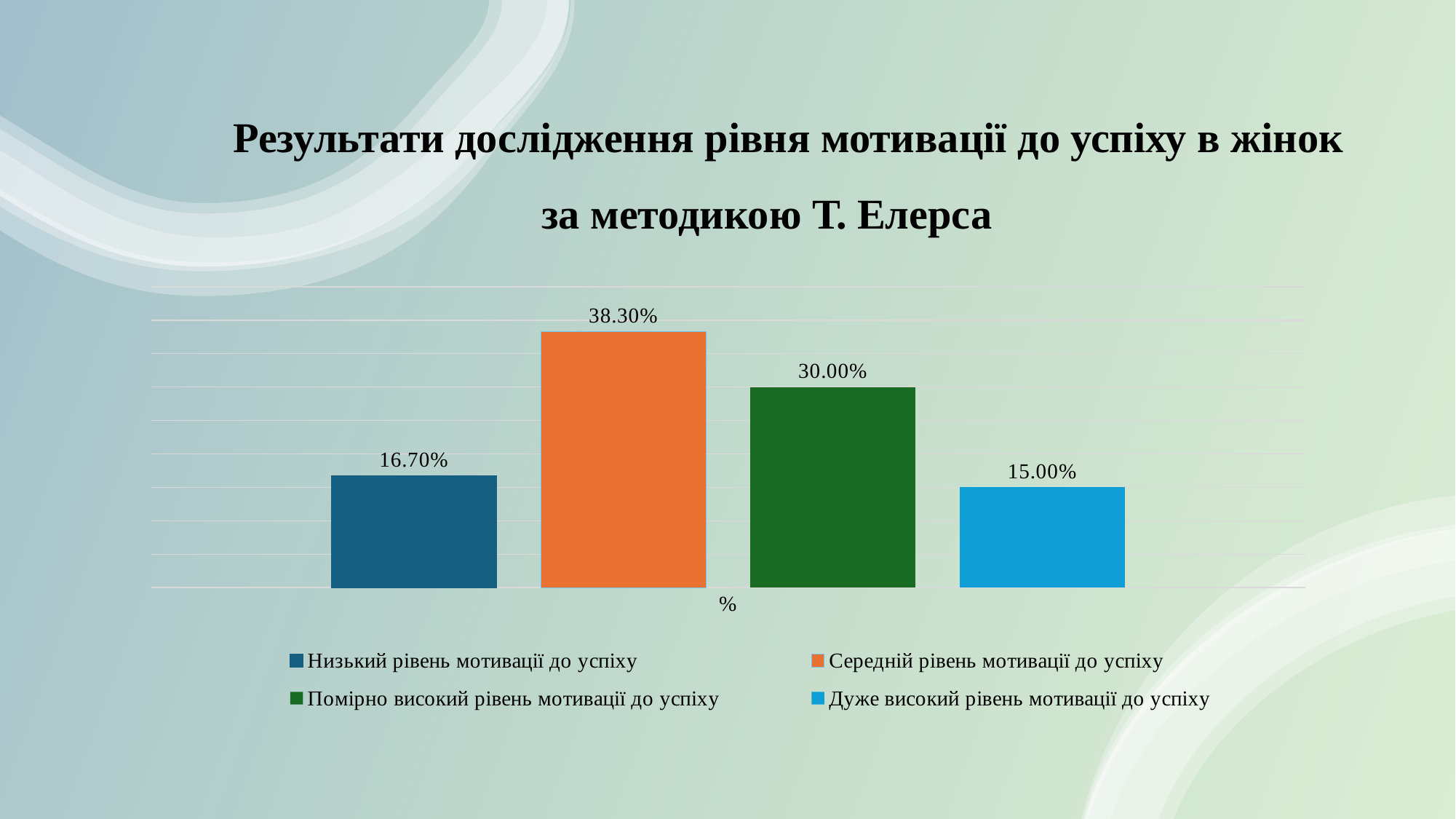
What is the difference between the values for Середній рівень мотивації до успіху and Помірно високий рівень мотивації до успіху? 8.30% What kind of chart is shown on the slide? Bar chart How many series does the legend list? 4 Which series has the highest value? Середній рівень мотивації до успіху What is the value for Середній рівень мотивації до успіху? 38.30% Which series has the lowest value? Дуже високий рівень мотивації до успіху Which is larger: the value for Помірно високий рівень мотивації до успіху or the value for Низький рівень мотивації до успіху? Помірно високий рівень мотивації до успіху What colour is the bar for Середній рівень мотивації до успіху? Orange What is the value for Низький рівень мотивації до успіху? 16.70% What is the value for Помірно високий рівень мотивації до успіху? 30.00% What is the value for Дуже високий рівень мотивації до успіху? 15.00% What is the difference between the values for Низький рівень мотивації до успіху and Дуже високий рівень мотивації до успіху? 1.70%